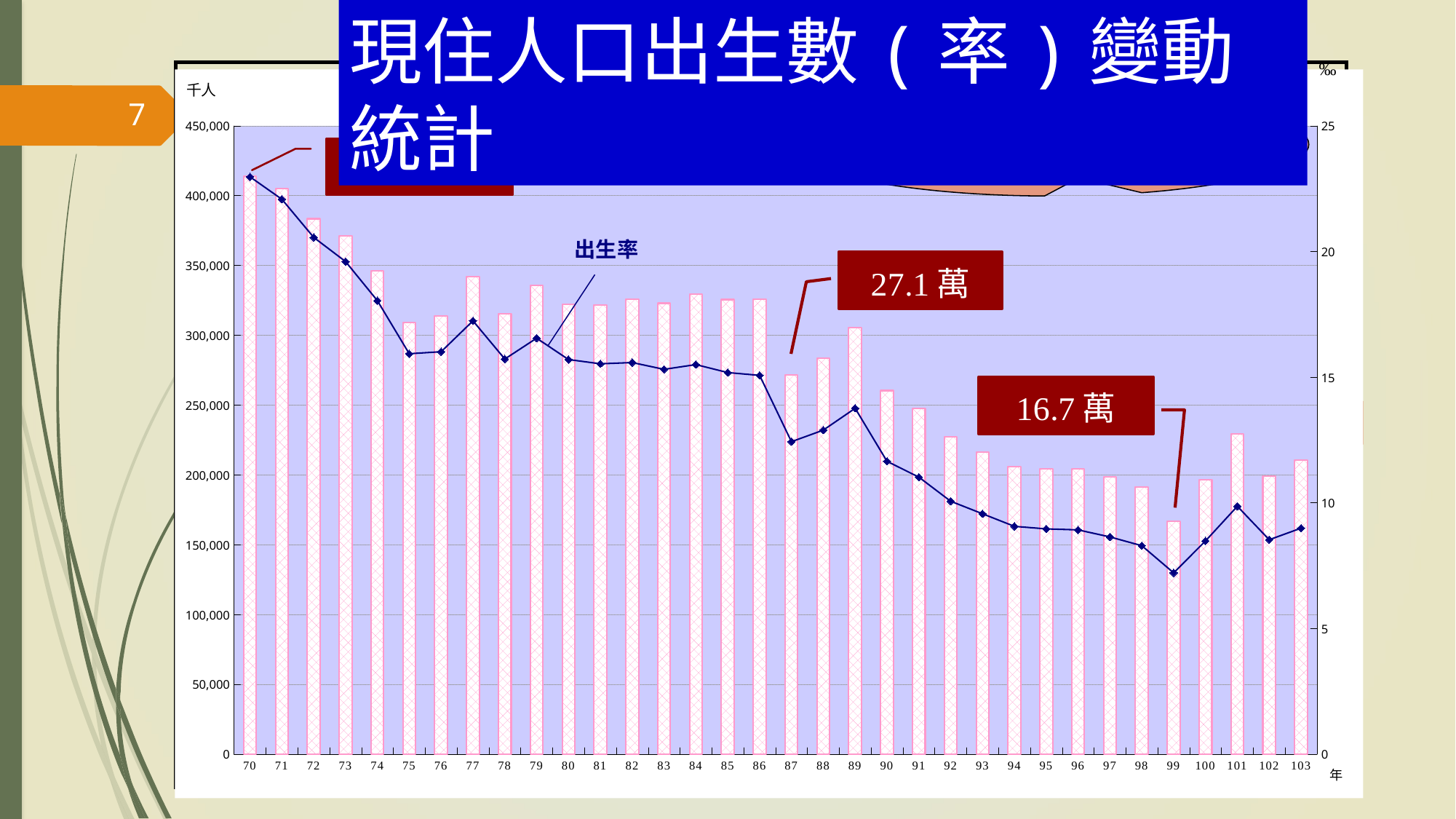
What is the difference between the two callout values, 27.1 萬 (year 87) and 16.7 萬 (year 99)? 10.4 萬 Which year has the larger bar, 101 or 102? 101 How many years are shown along the x axis? 34 Which year has the tallest bar (highest number of births)? 70 Which year has the shortest bar (lowest number of births)? 99 Is the 出生率 line value for year 87 greater or less than 15 on the right axis? less What is the overall trend of the 出生率 line from year 70 to year 103? Falling What value does the callout give for the number of births in year 99? 16.7 萬 What kind of chart is shown on the slide? A bar chart combined with a line chart Is the bar for year 70 greater or less than 400,000? greater Is the bar for year 103 greater or less than 200,000? greater What value does the callout give for the number of births in year 87? 27.1 萬